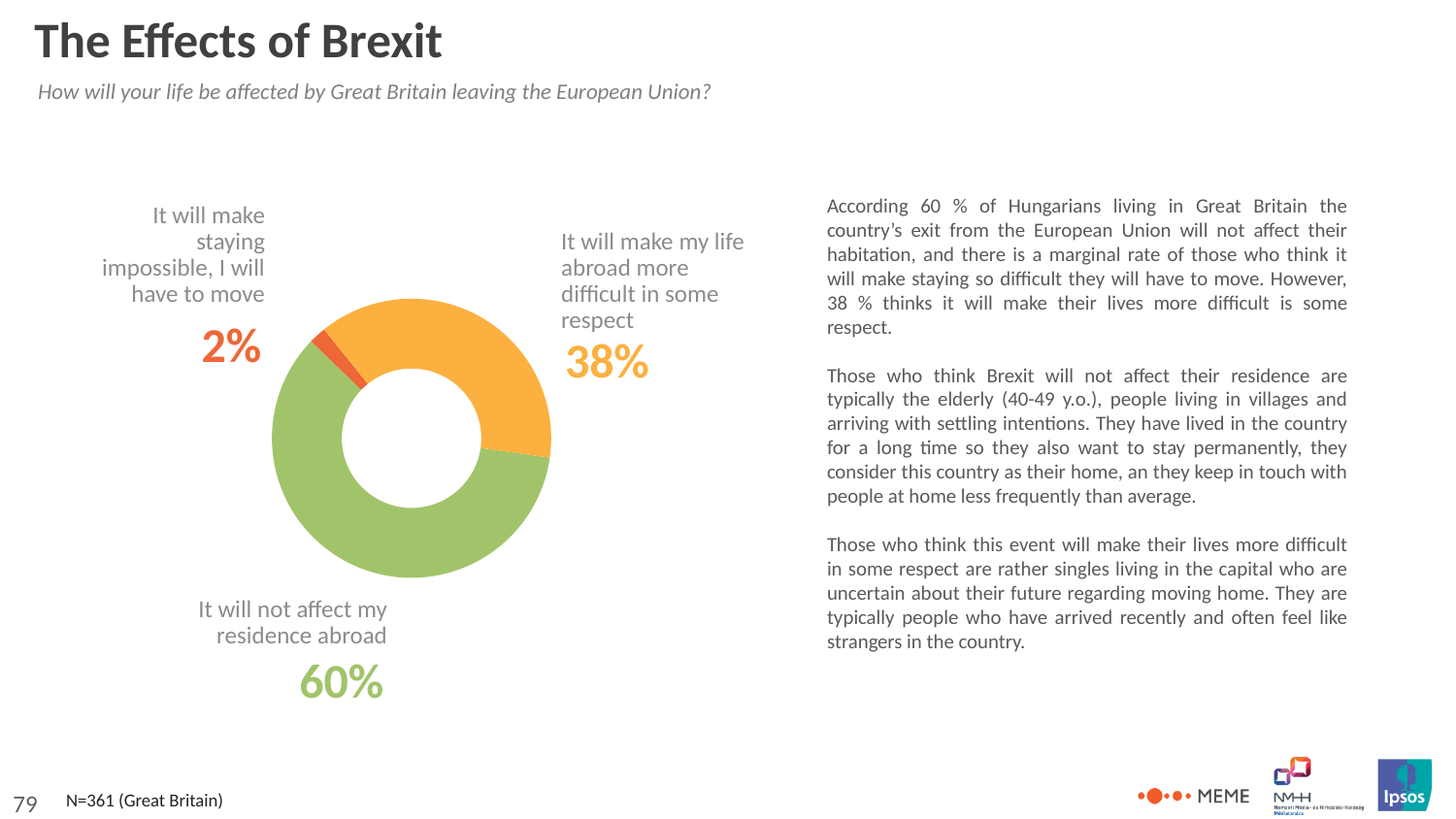
What is the sample size stated on the slide? N=361 (Great Britain) How many response categories are shown in the chart? 3 Which response has the largest share of the chart? It will not affect my residence abroad What percentage of respondents say Brexit will make staying impossible and they will have to move? 2% What colour is the segment representing 'It will not affect my residence abroad'? Green What percentage of respondents say Brexit will make their life abroad more difficult in some respect? 38% What is the combined share of the two responses indicating Brexit will have some negative effect (more difficult or have to move)? 40% What percentage of respondents say Brexit will not affect their residence abroad? 60% Which is larger: the share for 'It will make my life abroad more difficult in some respect' or the share for 'It will make staying impossible, I will have to move'? It will make my life abroad more difficult in some respect What is the difference in percentage points between 'It will not affect my residence abroad' and 'It will make my life abroad more difficult in some respect'? 22 percentage points Which response has the smallest share of the chart? It will make staying impossible, I will have to move What kind of chart is shown on the slide? Pie chart (doughnut)